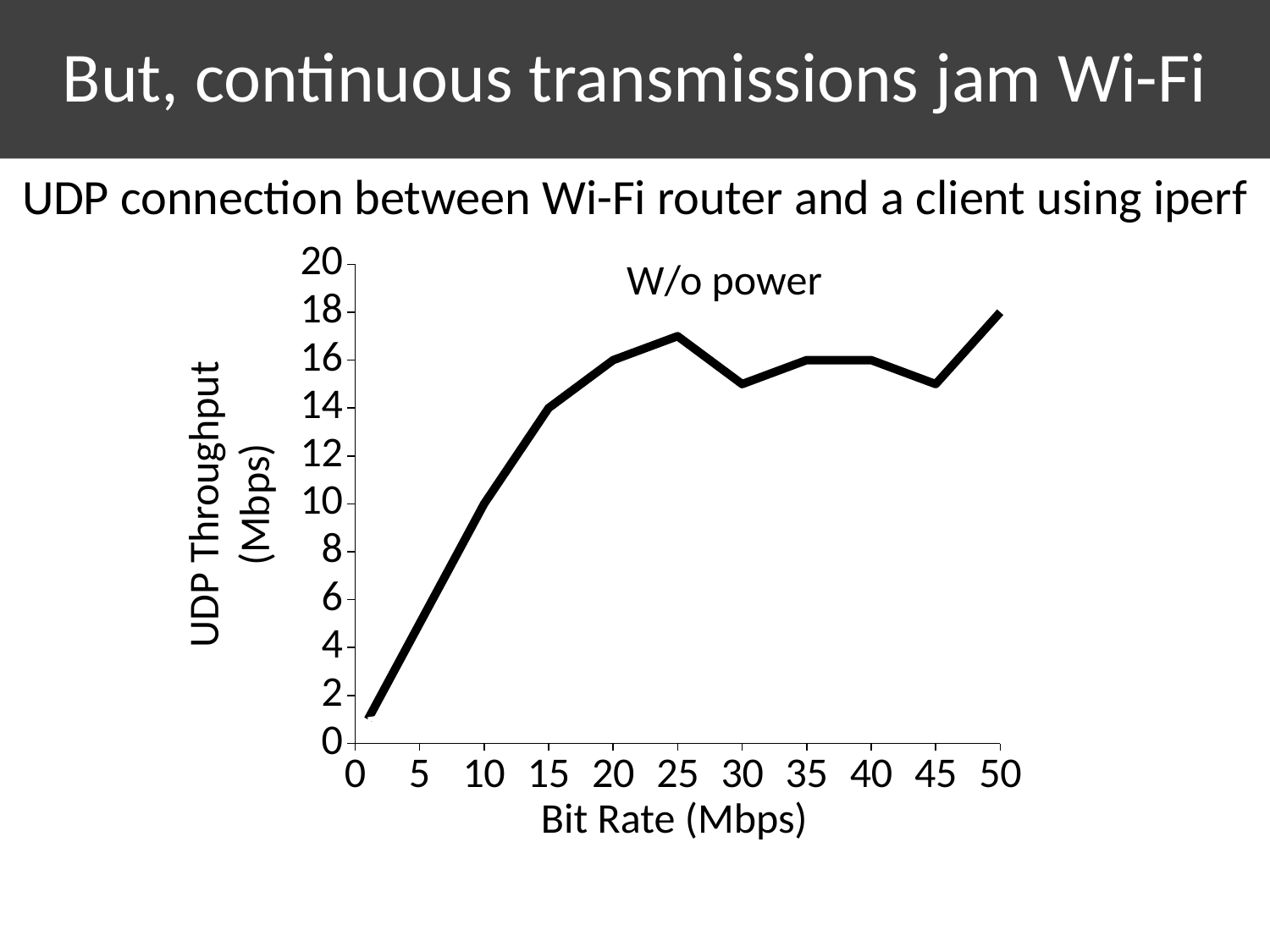
Is the UDP throughput at a bit rate of 25 Mbps greater or less than 16? greater What is the label of the series plotted in the chart? W/o power Is the UDP throughput at a bit rate of 30 Mbps greater or less than 16? less Does the UDP throughput generally rise or fall as the bit rate increases from 0 to 50 Mbps? rise How many series does the chart plot? 1 Is the UDP throughput at a bit rate of 15 Mbps greater or less than 12? greater What is the title of the x axis? Bit Rate (Mbps) At which bit rate is the UDP throughput highest? 50 What kind of chart is shown on the slide? line chart Which has the higher UDP throughput: a bit rate of 25 Mbps or 30 Mbps? 25 Mbps